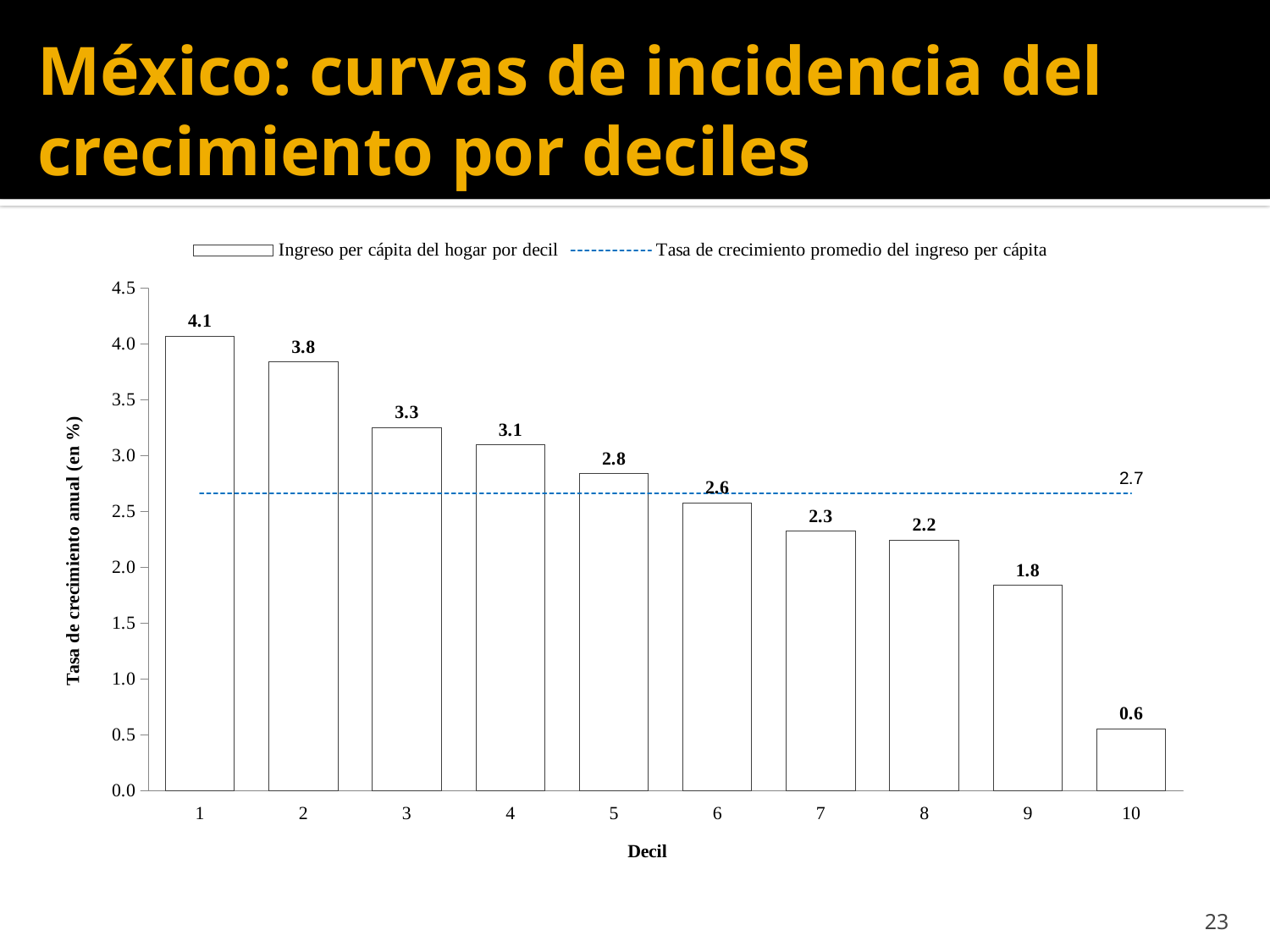
What is the annual growth rate for decile 10? 0.6 What value is labelled on the dashed line for the average growth rate of per capita income? 2.7 How many deciles are shown on the x axis? 10 What is the annual growth rate for decile 5? 2.8 How many series does the legend list? 2 Which decile has the lowest growth rate? 10 What kind of chart is used to show the growth rate by decile? Bar chart What is the difference between the growth rates of decile 1 and decile 10? 3.5 Which decile has the highest growth rate? 1 What is the annual growth rate for decile 1? 4.1 Do the growth rates rise or fall as the decile number increases? Fall Which has a higher growth rate, decile 3 or decile 7? Decile 3